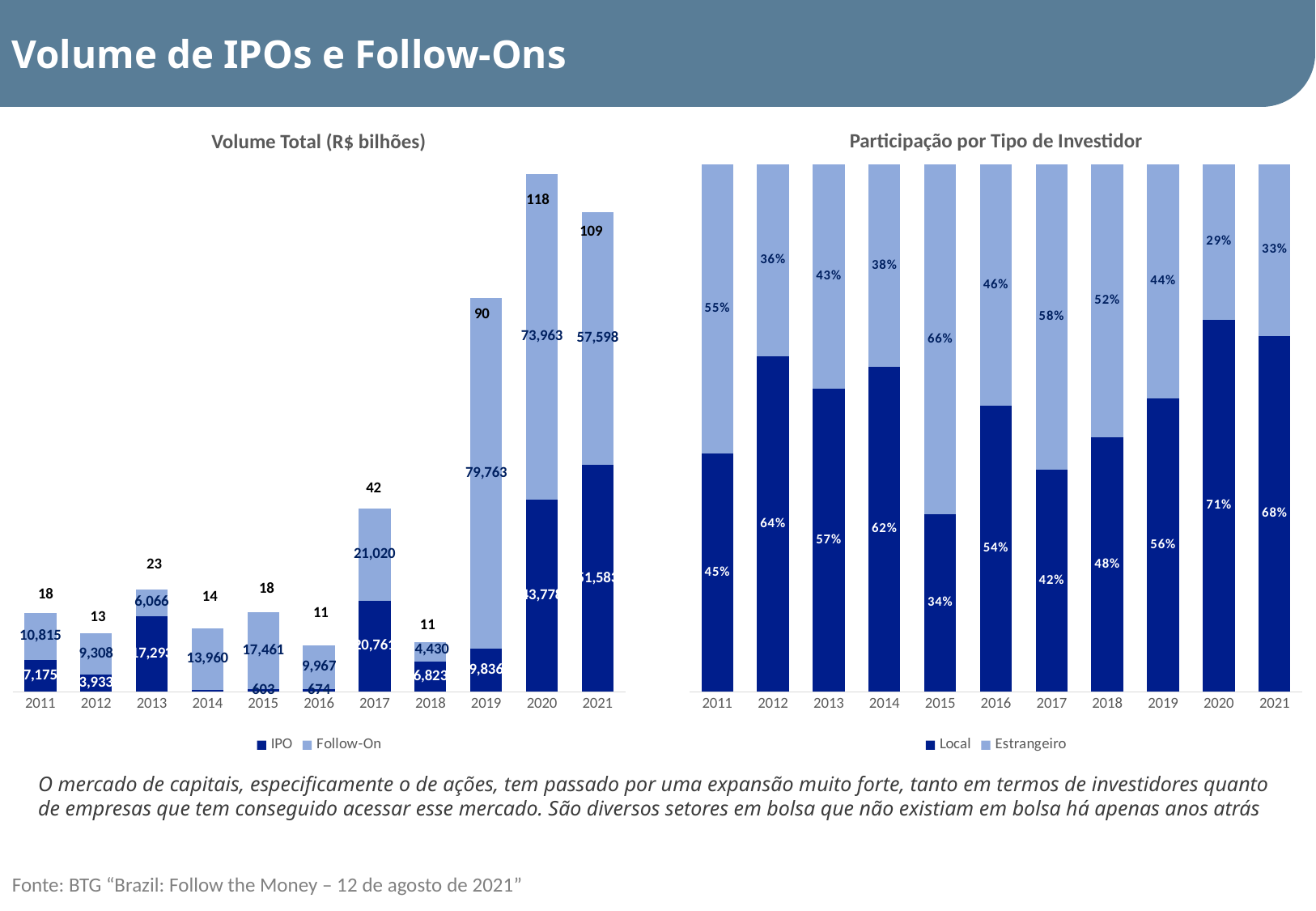
What kind of chart is the 'Volume Total (R$ bilhões)' chart? Stacked bar chart In the 'Volume Total (R$ bilhões)' chart, what is the total volume shown above the bar for 2020? 118 In the 'Participação por Tipo de Investidor' chart, which year has the lowest Local share? 2015 In the 'Volume Total (R$ bilhões)' chart, what is the Follow-On value for 2021? 57,598 How many years are shown on the x axis of the 'Participação por Tipo de Investidor' chart? 11 In the 'Participação por Tipo de Investidor' chart, which is larger in 2017, the Local share or the Estrangeiro share? Estrangeiro In the 'Volume Total (R$ bilhões)' chart, what is the Follow-On value for 2019? 79,763 In the 'Volume Total (R$ bilhões)' chart, which year has the highest total volume? 2020 In the 'Volume Total (R$ bilhões)' chart, what is the difference between the total volumes for 2020 and 2021? 9 In the 'Participação por Tipo de Investidor' chart, what is the Local share for 2020? 71% In the 'Participação por Tipo de Investidor' chart, what is the Estrangeiro share for 2015? 66% How many series does the legend of the 'Volume Total (R$ bilhões)' chart list? 2